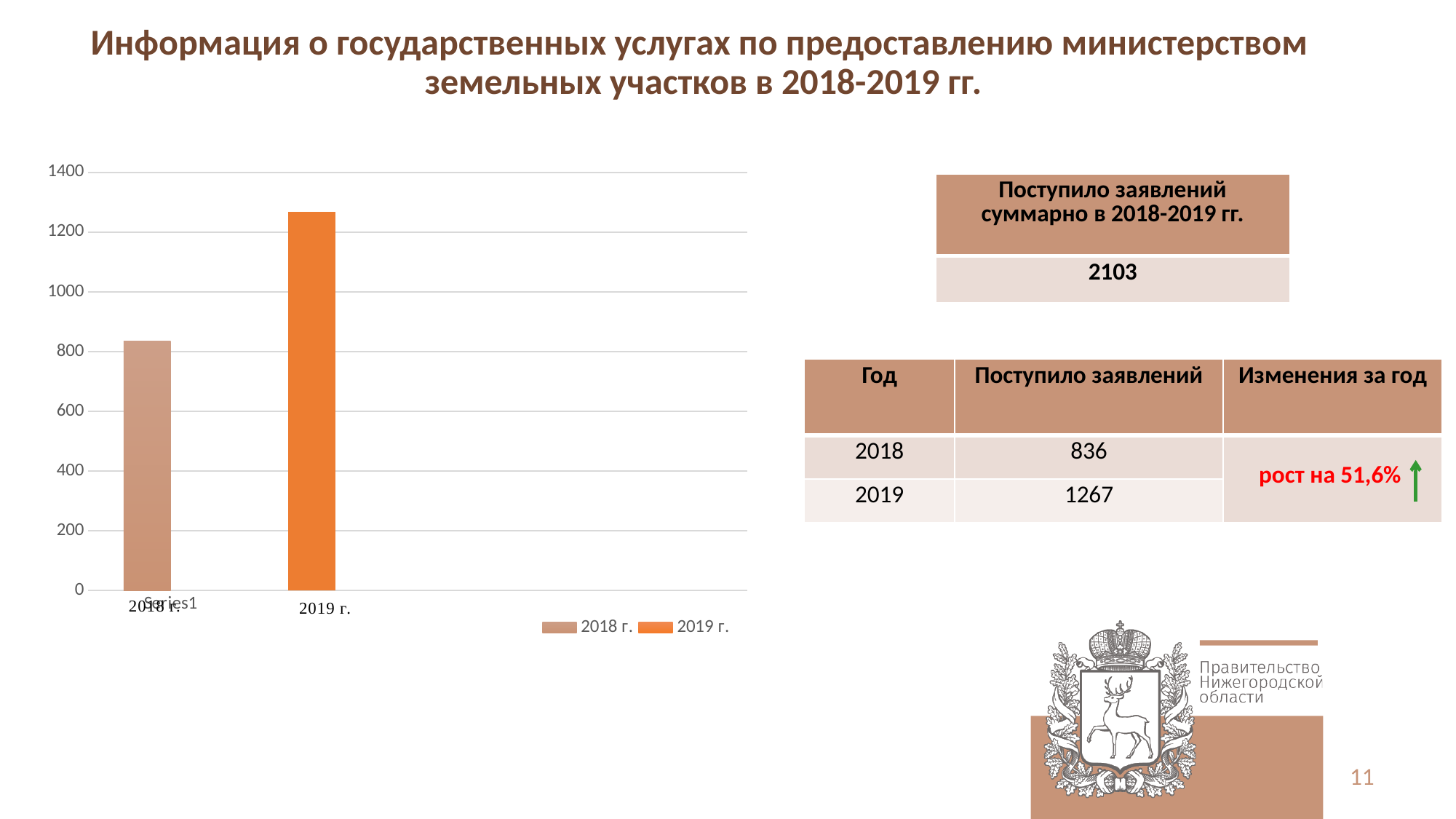
Which bar is the shortest in the chart? 2018 г. How many series does the chart legend list? 2 What kind of chart is shown on the slide? bar chart Is the value for 2018 г. greater or less than 800? greater Is the value for 2018 г. greater or less than 1000? less Is the value for 2019 г. greater or less than 1200? greater Do the values rise or fall from 2018 г. to 2019 г.? rise What is the value for 2019 г. according to the table on the slide? 1267 Which bar is the tallest in the chart? 2019 г. How many bars are plotted in the chart? 2 What colour is the bar for 2019 г.? orange Which is larger, the bar for 2018 г. or the bar for 2019 г.? 2019 г.